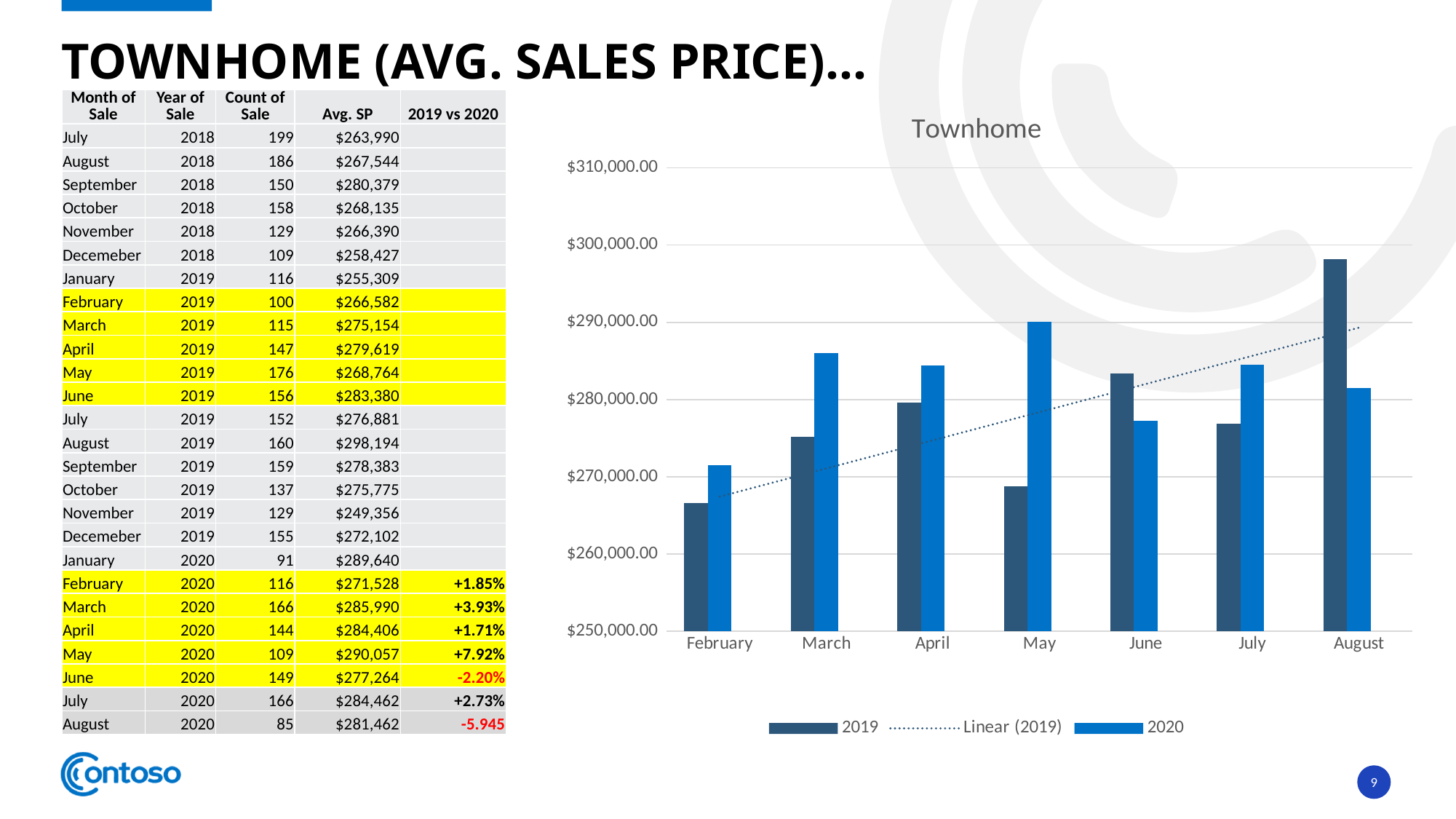
In August, which bar is taller, 2019 or 2020? 2019 How many entries does the chart legend list? 3 How many months are shown on the x axis of the chart? 7 Is the 2020 value for June greater or less than $280,000.00? less Does the Linear (2019) trendline rise or fall from February to August? rise What kind of chart is shown on the slide? bar chart In March, which bar is taller, 2019 or 2020? 2020 Which month has the highest 2019 bar in the chart? August Which month has the lowest 2020 bar in the chart? February Which month has the highest 2020 bar in the chart? May What is the title of the chart? Townhome Is the 2019 value for August greater or less than $290,000.00? greater